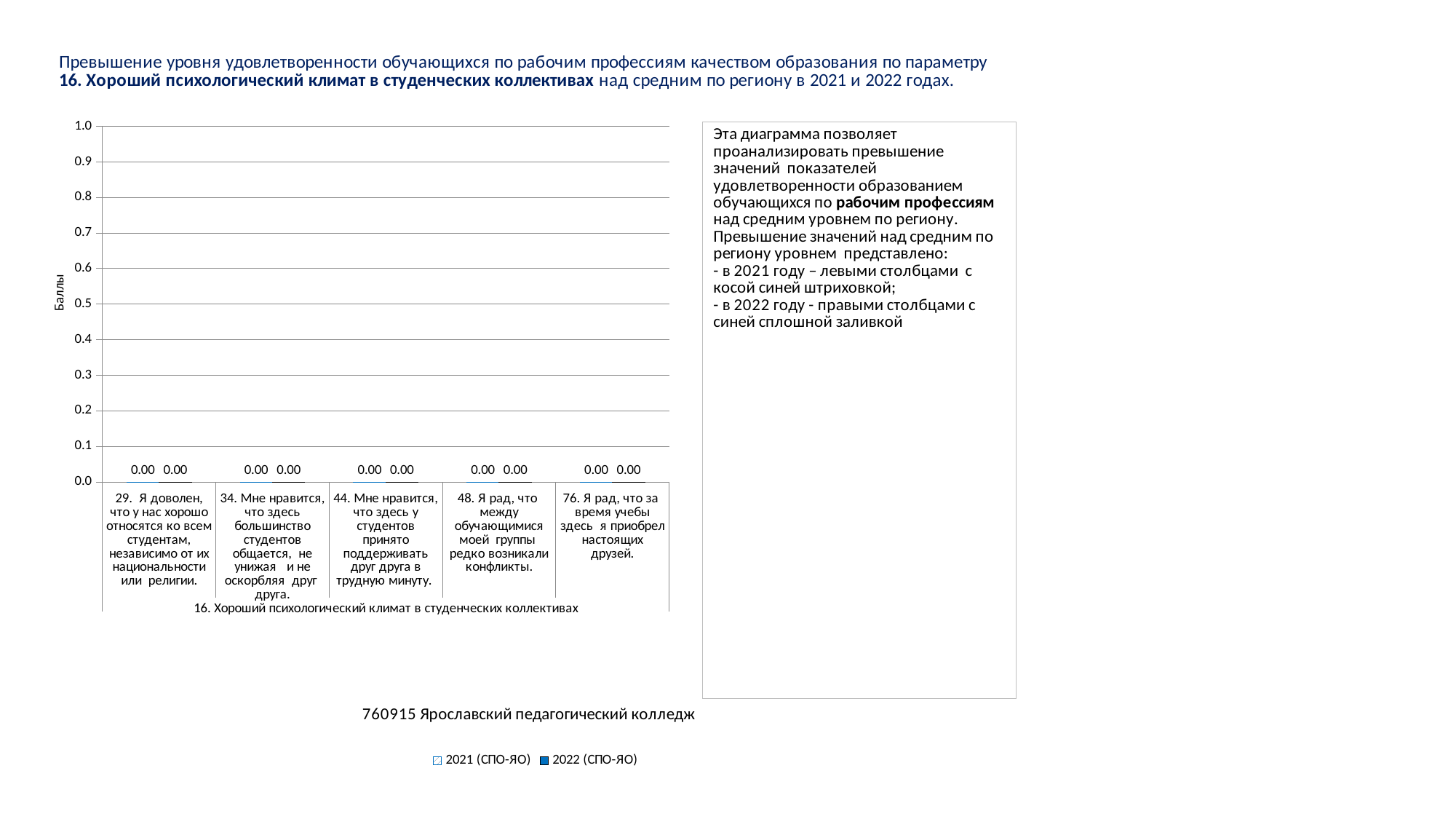
What kind of chart is shown on the slide? bar chart How many series does the legend list? 2 What is the value for 2022 (СПО-ЯО) for category 76 (Я рад, что за время учебы здесь я приобрел настоящих друзей)? 0.00 How many categories are shown on the x axis of the chart? 5 Is the value for 2022 (СПО-ЯО) for category 29 greater or less than 0.1? less What is the label of the vertical axis of the chart? Баллы What are the two series names listed in the legend? 2021 (СПО-ЯО) and 2022 (СПО-ЯО) What is the value for 2021 (СПО-ЯО) for category 48 (Я рад, что между обучающимися моей группы редко возникали конфликты)? 0.00 What is the difference between the 2021 (СПО-ЯО) and 2022 (СПО-ЯО) values for category 44 (Мне нравится, что здесь у студентов принято поддерживать друг друга в трудную минуту)? 0.00 What is the value for 2022 (СПО-ЯО) for category 34 (Мне нравится, что здесь большинство студентов общается, не унижая и не оскорбляя друг друга)? 0.00 What is the value for 2021 (СПО-ЯО) for category 29 (Я доволен, что у нас хорошо относятся ко всем студентам...)? 0.00 What is the highest value shown on the vertical axis of the chart? 1.0